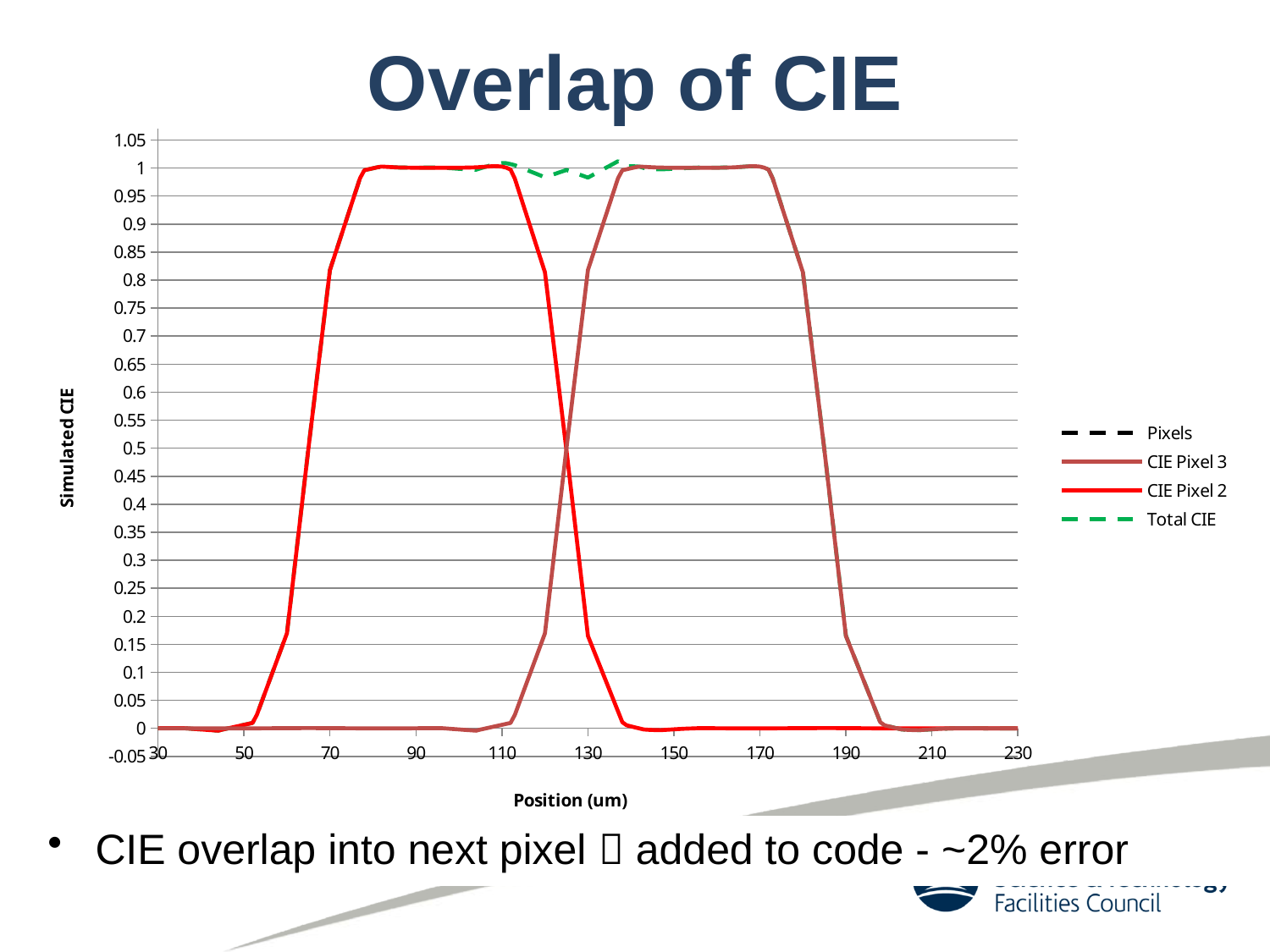
What is the title of the x axis? Position (um) What is the title of the y axis? Simulated CIE Between positions 110 and 130, does the CIE Pixel 2 line rise or fall? fall Is the value of CIE Pixel 3 at position 170 greater or less than 0.5? greater Is the value of CIE Pixel 2 at position 90 greater or less than 0.5? greater Is the value of CIE Pixel 2 at position 170 greater or less than 0.5? less Between positions 110 and 130, does the CIE Pixel 3 line rise or fall? rise How many series does the legend list? 4 What kind of chart is shown on the slide? line chart At position 90, which series has the larger value, CIE Pixel 2 or CIE Pixel 3? CIE Pixel 2 At position 170, which series has the larger value, CIE Pixel 2 or CIE Pixel 3? CIE Pixel 3